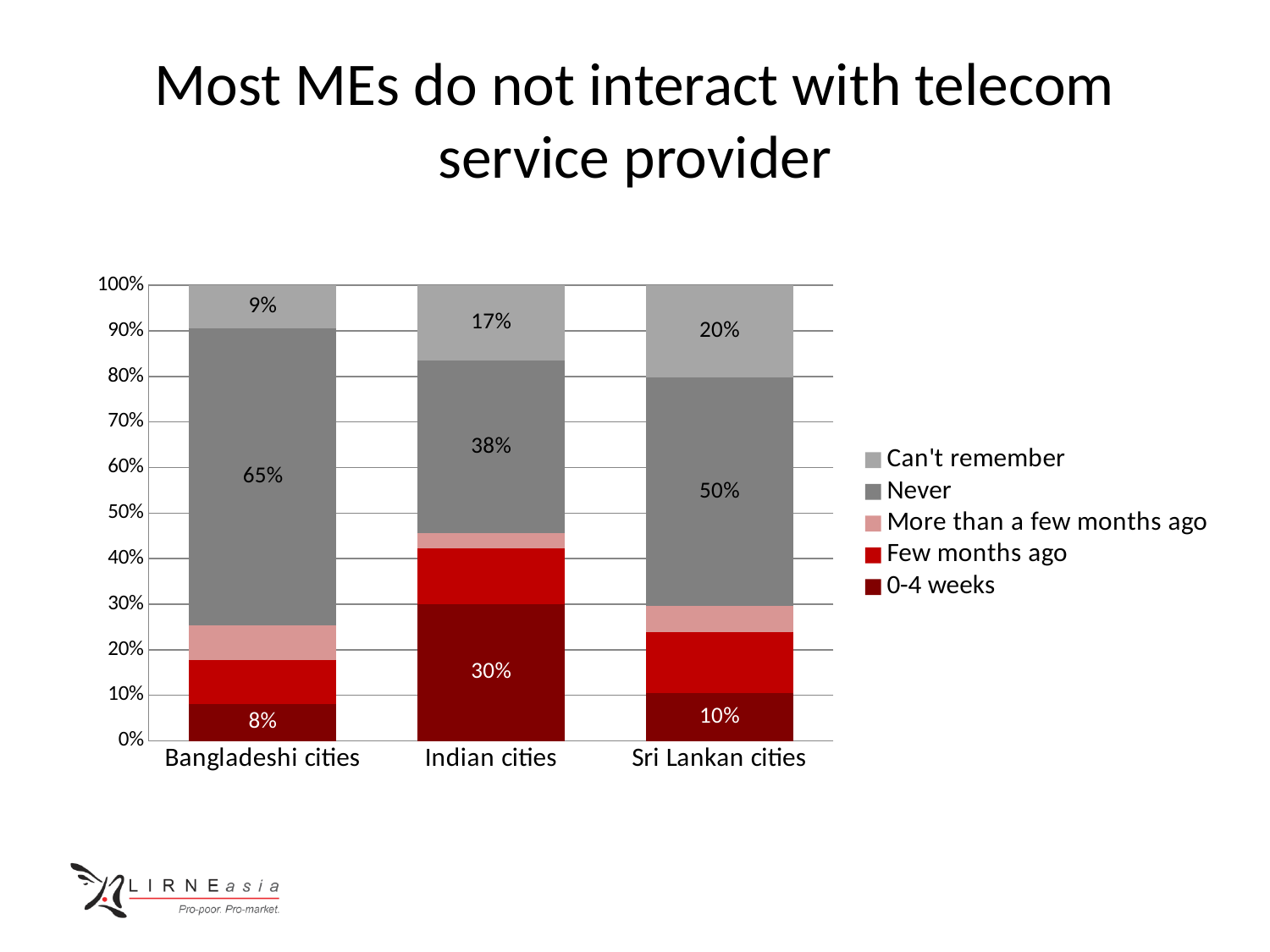
What is the value for "Can't remember" for Sri Lankan cities? 20% What is the value for "Never" for Indian cities? 38% Which is larger: the "Can't remember" value for Indian cities or for Sri Lankan cities? Sri Lankan cities What kind of chart is shown on the slide? Stacked bar chart What is the value for "0-4 weeks" for Bangladeshi cities? 8% What is the difference between the "Never" values for Bangladeshi cities and Sri Lankan cities? 15% What is the title of the slide? Most MEs do not interact with telecom service provider Which category has the lowest value for "0-4 weeks"? Bangladeshi cities How many categories are shown on the x axis? 3 Is the "Few months ago" segment for Indian cities greater or less than 20%? less Which category has the highest value for "Never"? Bangladeshi cities How many series does the legend list? 5